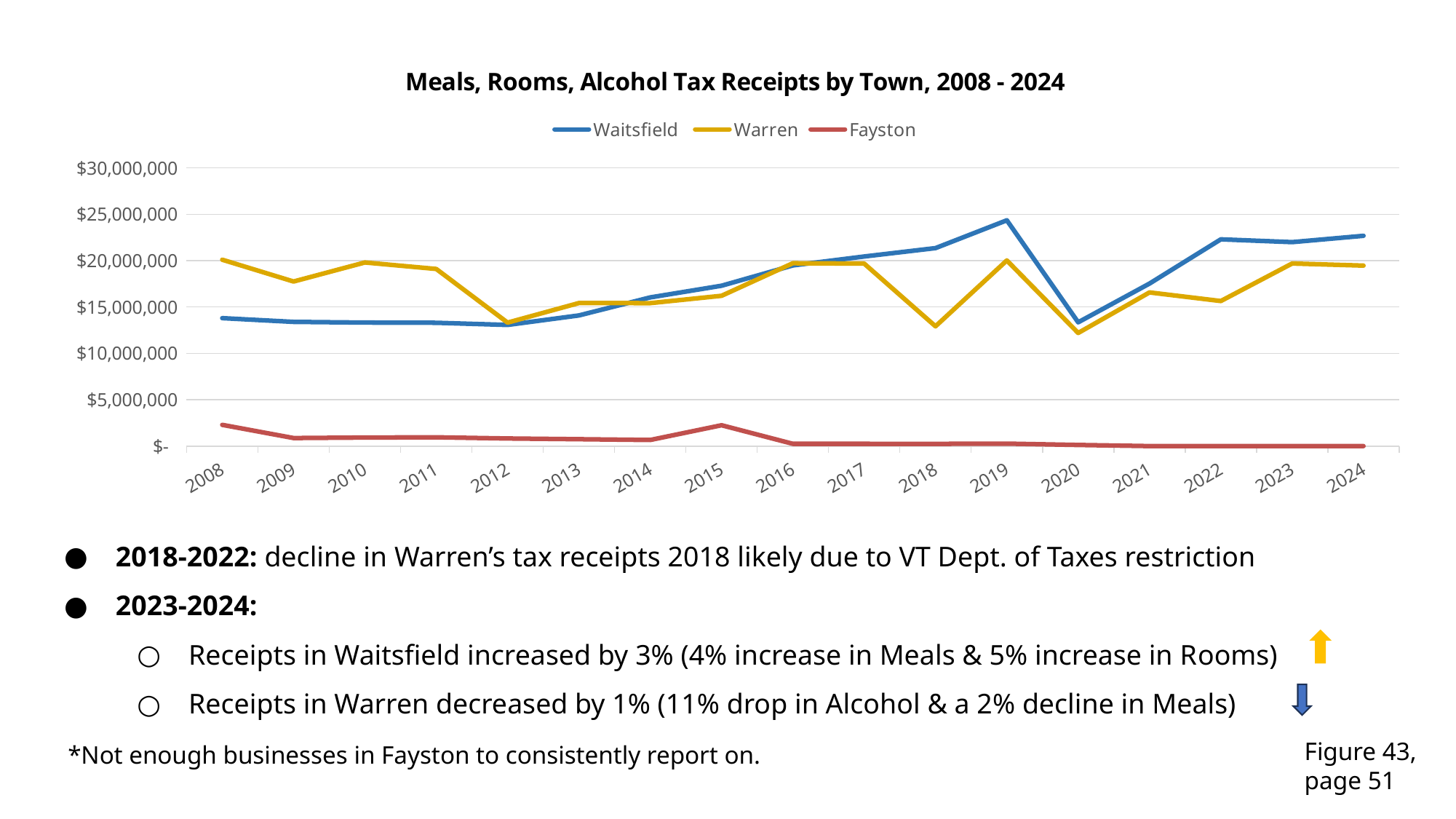
Is the value for Warren in 2020 greater or less than $15,000,000? less How many series does the legend list? 3 Is the value for Fayston in 2008 greater or less than $5,000,000? less What kind of chart is shown on the slide? line chart Is the value for Waitsfield in 2019 greater or less than $20,000,000? greater In 2022, which town had higher tax receipts, Waitsfield or Warren? Waitsfield In which year did Waitsfield reach its highest tax receipts? 2019 What is the title of the chart? Meals, Rooms, Alcohol Tax Receipts by Town, 2008 - 2024 How many years are plotted along the x axis? 17 In 2008, which town had higher tax receipts, Waitsfield or Warren? Warren Which colour is used for the Waitsfield line? blue